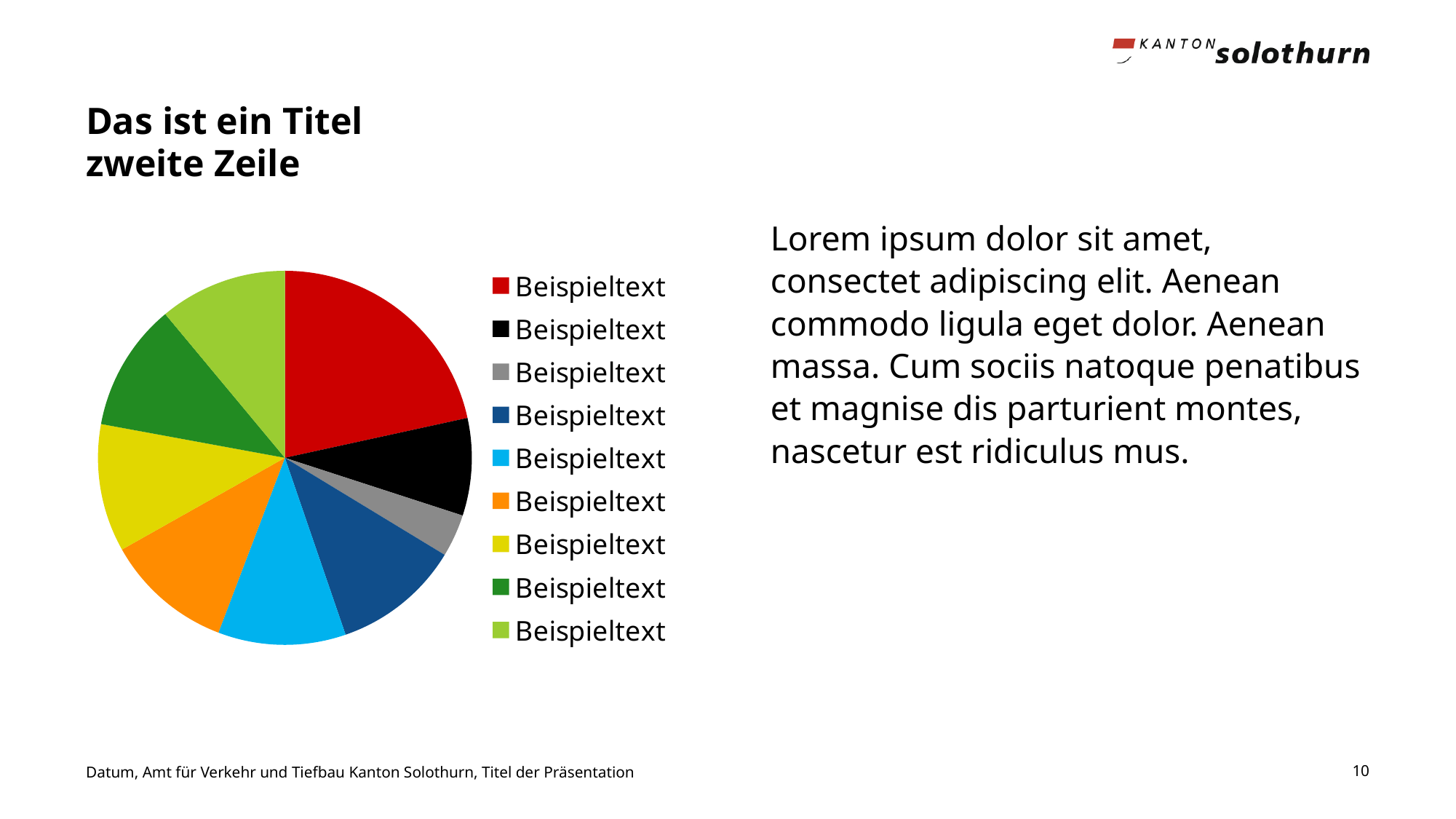
What label is shown for every entry in the pie chart's legend? Beispieltext Which slice is larger in the pie chart, the grey slice or the orange slice? The orange slice How many entries does the legend of the pie chart list? 9 Which slice is larger in the pie chart, the red slice or the black slice? The red slice What colour is the first entry in the pie chart's legend? Red How many slices does the pie chart have? 9 Which slice of the pie chart is the smallest? The grey slice What kind of chart is shown on the slide? Pie chart Which slice is larger in the pie chart, the grey slice or the black slice? The black slice Which slice of the pie chart is the largest? The red slice